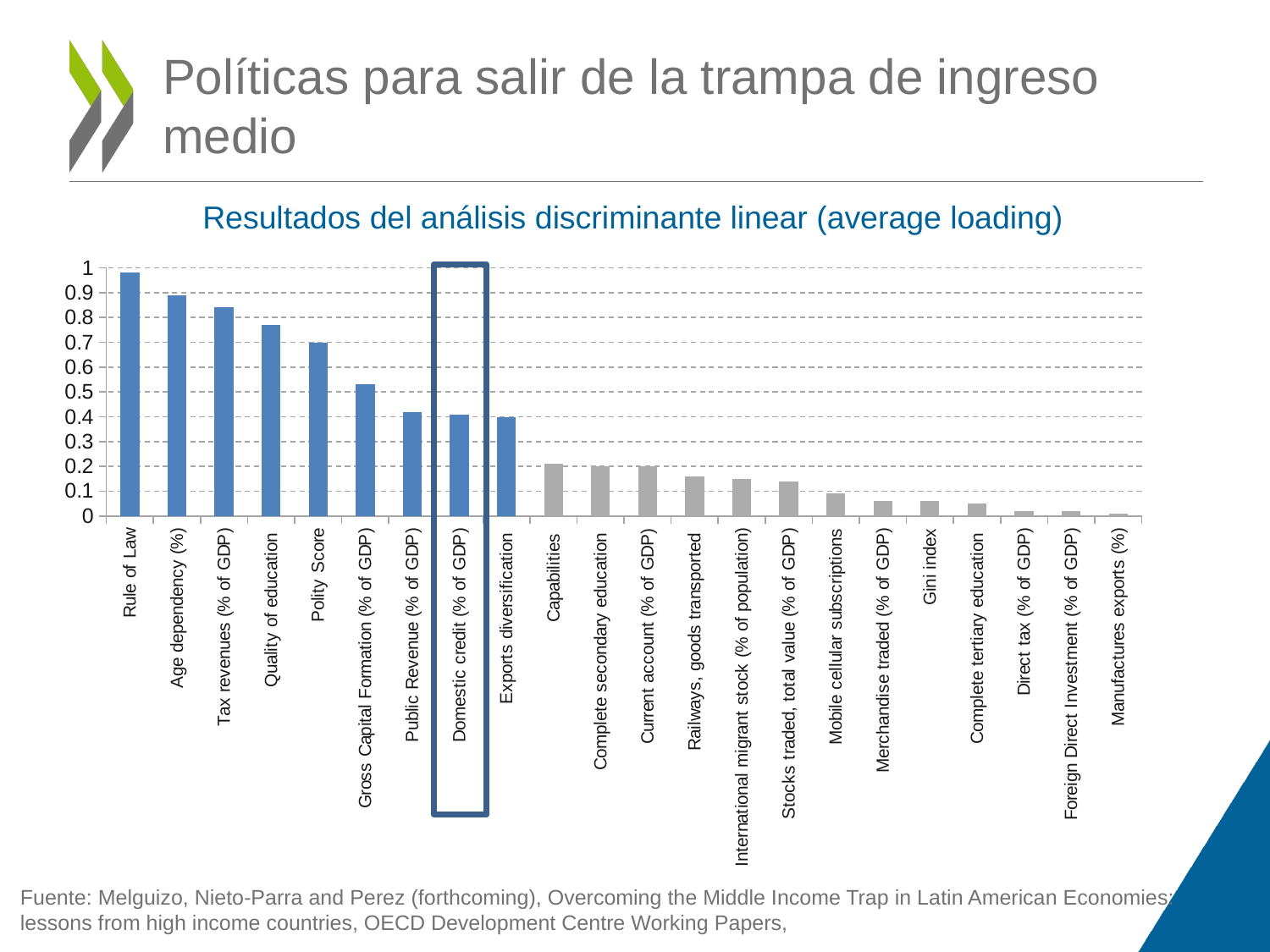
Which category has the highest value on the chart? Rule of Law Which is larger, the value for Polity Score or the value for Gross Capital Formation (% of GDP)? Polity Score How many categories are plotted on the chart? 22 Which is larger, the value for Quality of education or the value for Exports diversification? Quality of education Is the value for Gini index greater or less than 0.1? less Is the value for Rule of Law greater or less than 0.9? greater Is the value for Domestic credit (% of GDP) greater or less than 0.3? greater Do the values rise or fall moving from left to right along the x axis? fall Which category is highlighted with a dark outlined box on the chart? Domestic credit (% of GDP) What kind of chart is shown on the slide? Bar chart